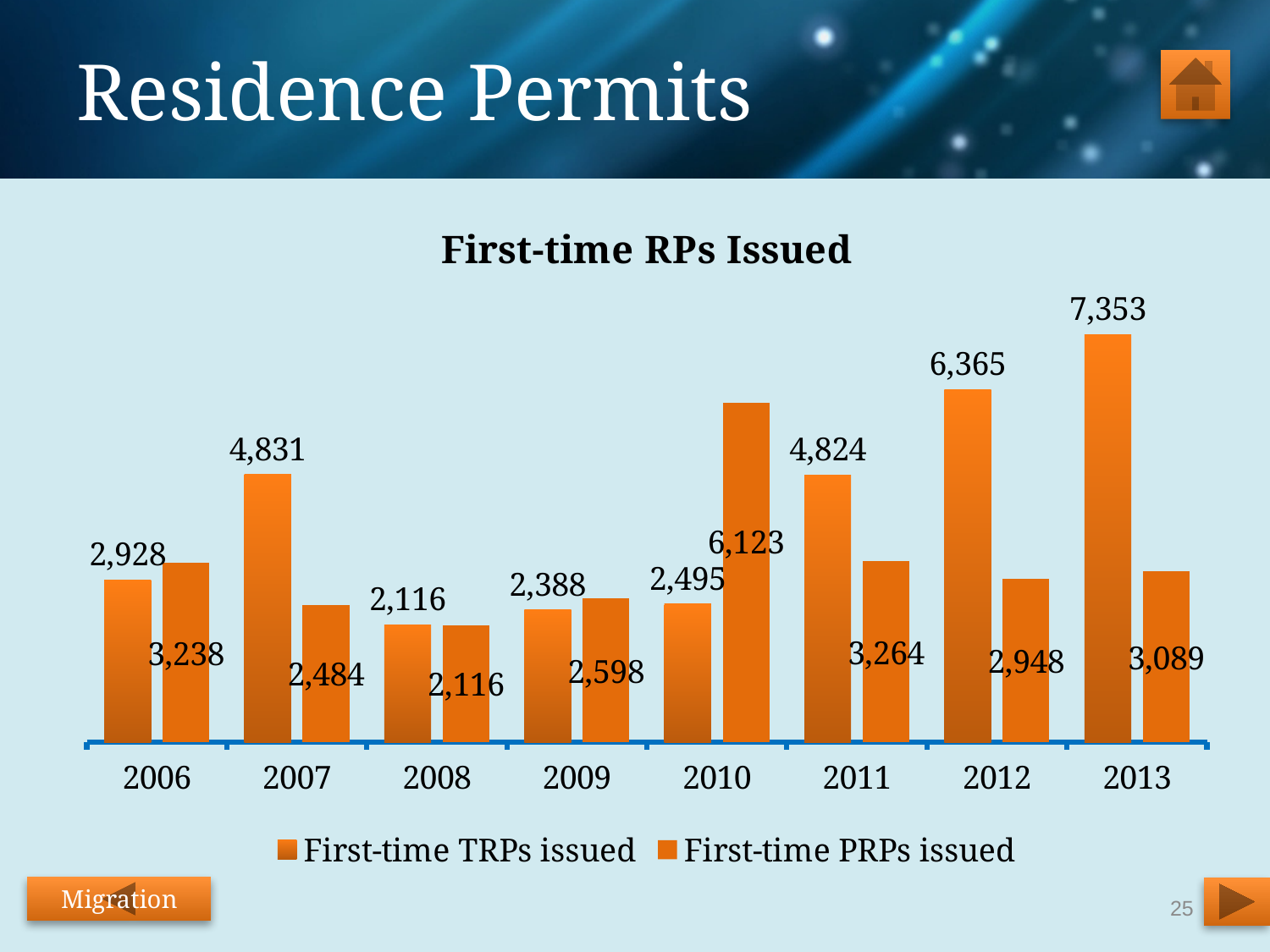
Do First-time TRPs issued rise or fall from 2011 to 2013? Rise How many series does the legend list? 2 How many years are shown on the x axis? 8 What is the value for First-time TRPs issued in 2013? 7,353 What is the value for First-time PRPs issued in 2006? 3,238 In which year were the most First-time TRPs issued? 2013 What is the difference between First-time TRPs issued and First-time PRPs issued in 2013? 4,264 Which was larger in 2006: First-time TRPs issued or First-time PRPs issued? First-time PRPs issued What kind of chart is shown on the slide? Bar chart In which year were the most First-time PRPs issued? 2010 What is the value for First-time PRPs issued in 2010? 6,123 In which year were the fewest First-time TRPs issued? 2008